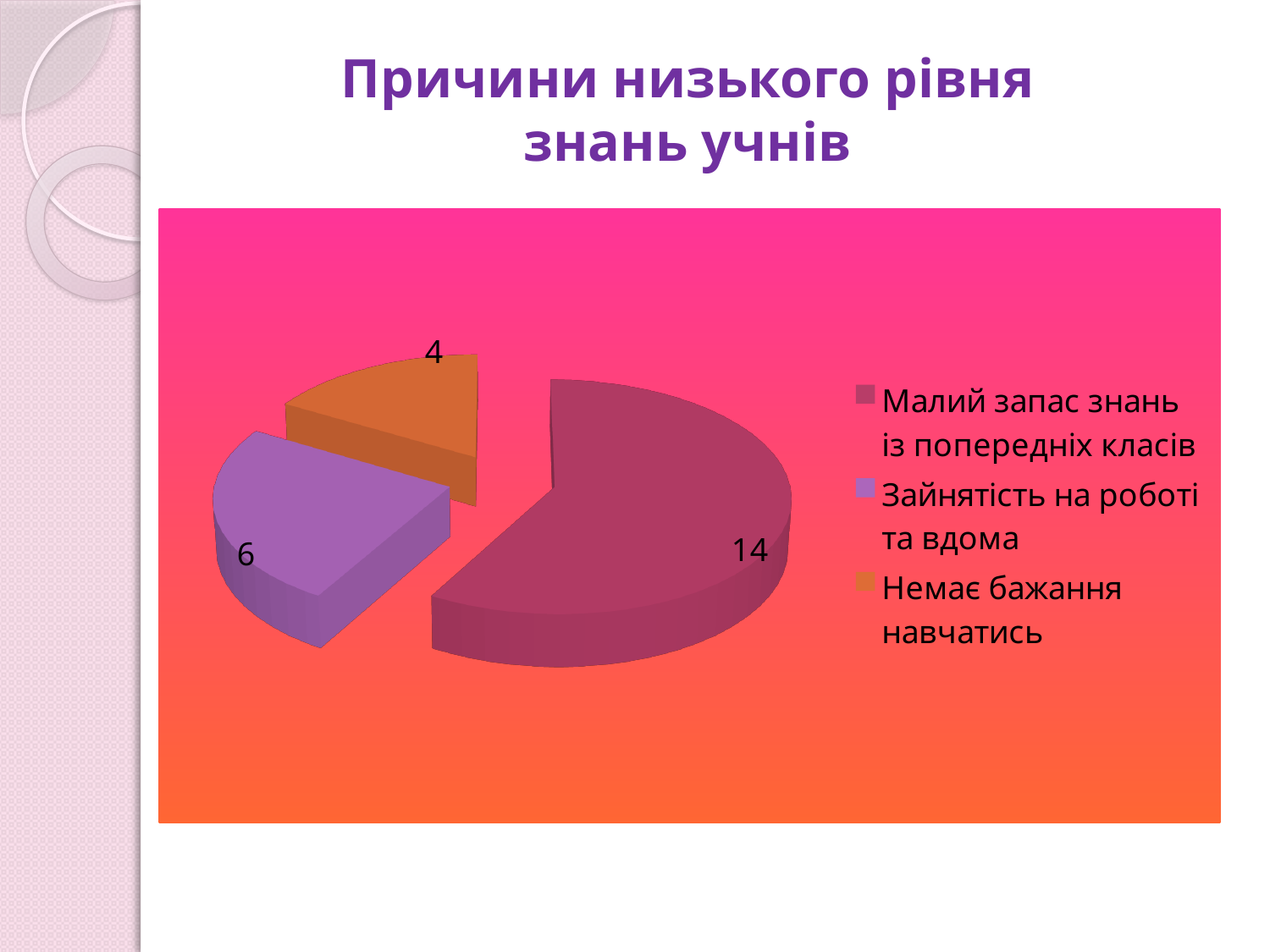
What is the value for "Зайнятість на роботі та вдома"? 6 What is the difference between the values for "Малий запас знань із попередніх класів" and "Зайнятість на роботі та вдома"? 8 What is the total of all slices in the pie chart? 24 Which category has the largest slice? Малий запас знань із попередніх класів How many slices does the pie chart have? 3 Which is larger: "Зайнятість на роботі та вдома" or "Немає бажання навчатись"? Зайнятість на роботі та вдома What type of chart is shown on the slide? Pie chart What is the title of the chart on the slide? Причини низького рівня знань учнів Which category has the smallest slice? Немає бажання навчатись What is the value for "Малий запас знань із попередніх класів"? 14 What is the value for "Немає бажання навчатись"? 4 What share of the pie does "Немає бажання навчатись" represent? 4 out of 24 (1/6)